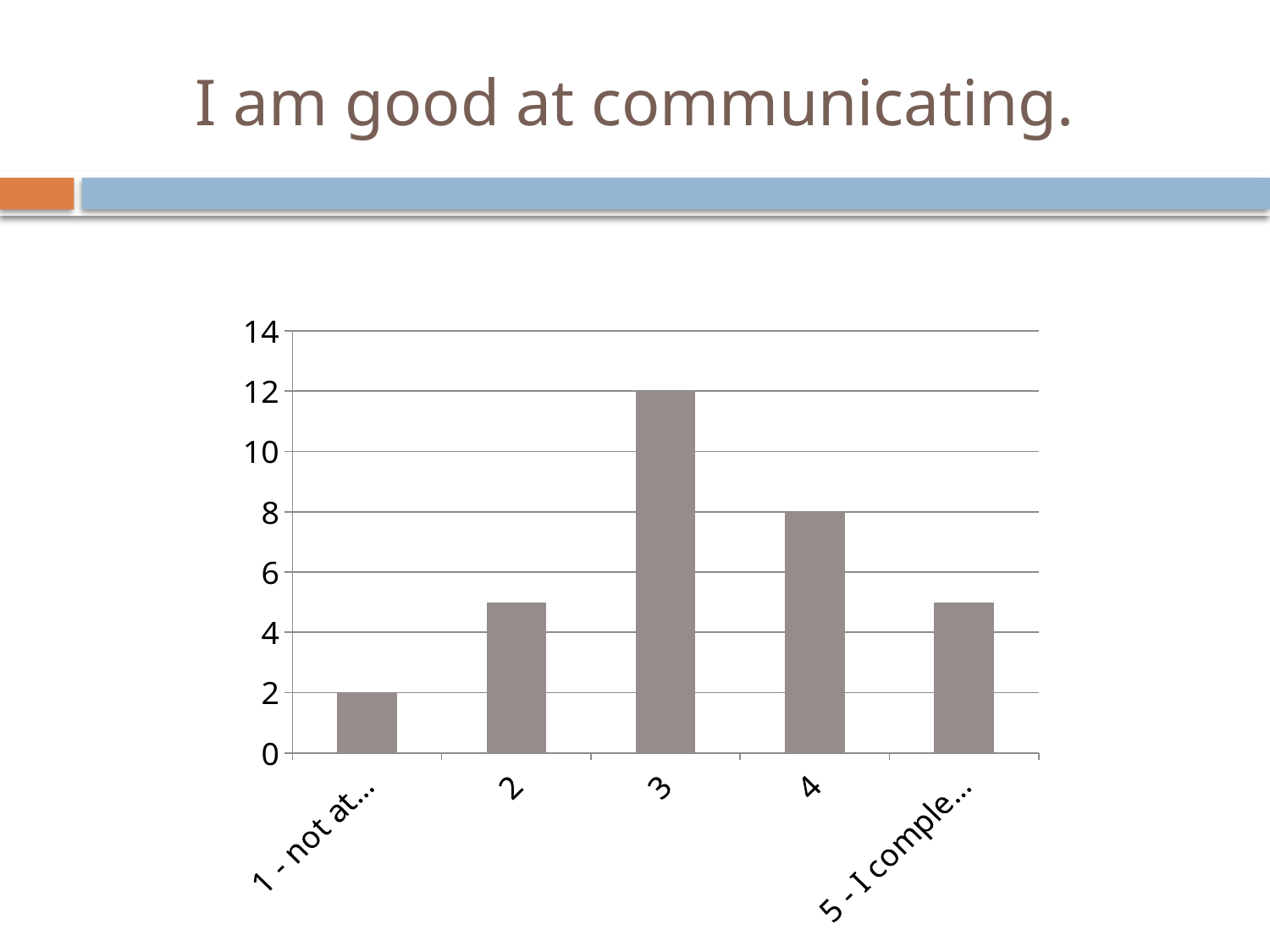
What is the value for the first category, "1 - not at..."? 2 What is the value for category 4? 8 What is the difference between the values for category 3 and category 4? 4 What kind of chart is shown on the slide? bar chart Is the value for category 2 greater or less than 4? greater What is the value for category 3? 12 Which category has the highest bar? 3 How many categories are shown on the x axis of the chart? 5 Is the value for the last category, "5 - I comple...", greater or less than 6? less What is the difference between the value for category 3 and the value for the first category, "1 - not at..."? 10 Which is larger, the value for category 3 or the value for category 4? 3 Which category has the lowest bar? 1 - not at...